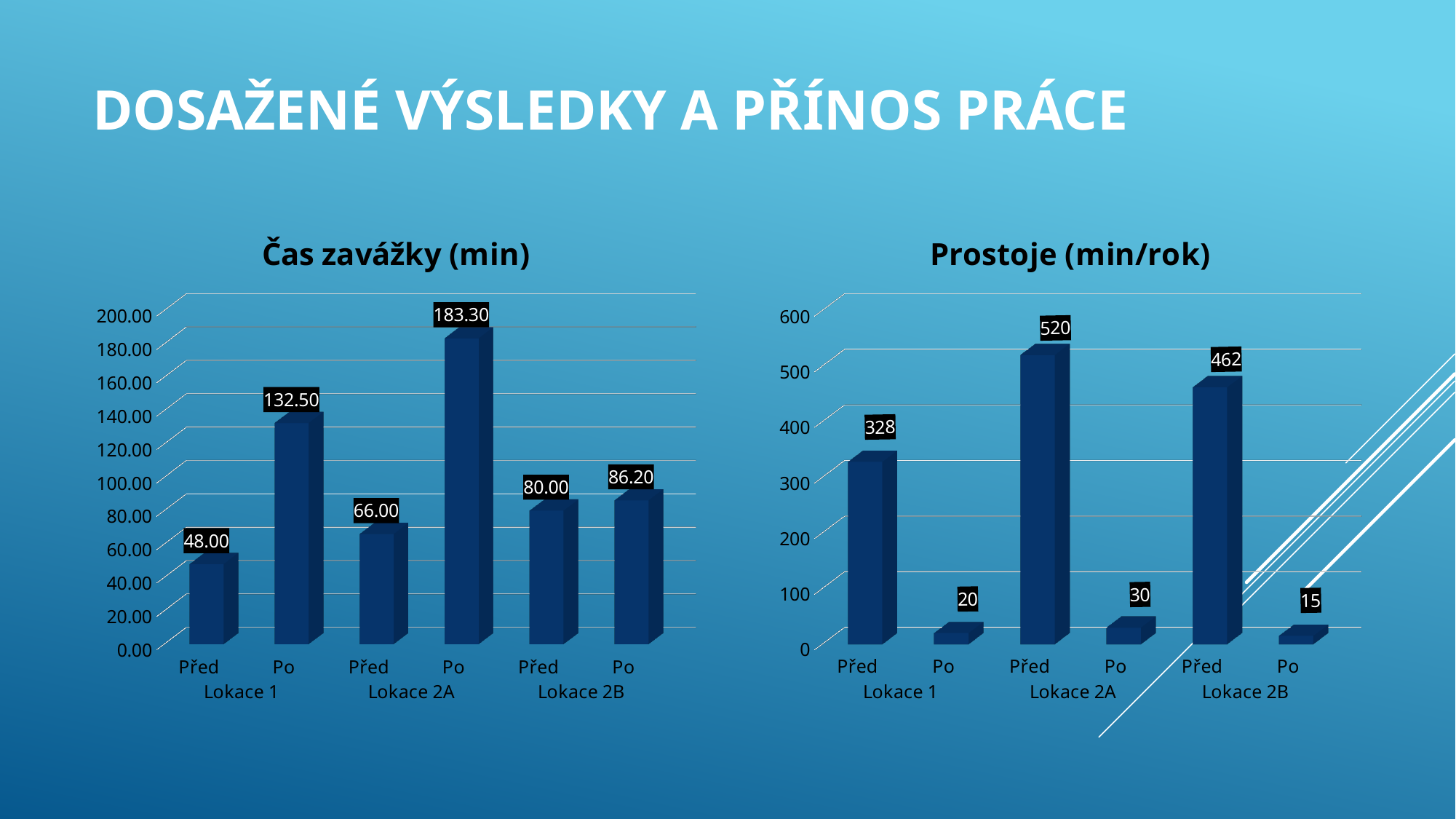
What type of chart is the 'Prostoje (min/rok)' chart? Bar chart In the 'Čas zavážky (min)' chart, what is the value for Po at Lokace 2A? 183.30 In the 'Čas zavážky (min)' chart, which bar has the highest value? Po, Lokace 2A In the 'Prostoje (min/rok)' chart, which bar has the lowest value? Po, Lokace 2B In the 'Čas zavážky (min)' chart, how many bars are plotted? 6 In the 'Čas zavážky (min)' chart, what is the difference between Po and Před at Lokace 1? 84.50 In the 'Prostoje (min/rok)' chart, what is the difference between Před and Po at Lokace 1? 308 In the 'Čas zavážky (min)' chart, which bar has the lowest value? Před, Lokace 1 In the 'Čas zavážky (min)' chart, what is the value for Před at Lokace 1? 48.00 In the 'Prostoje (min/rok)' chart, which bar has the highest value? Před, Lokace 2A In the 'Prostoje (min/rok)' chart, what is the value for Před at Lokace 2B? 462 In the 'Prostoje (min/rok)' chart, what is the value for Po at Lokace 2A? 30